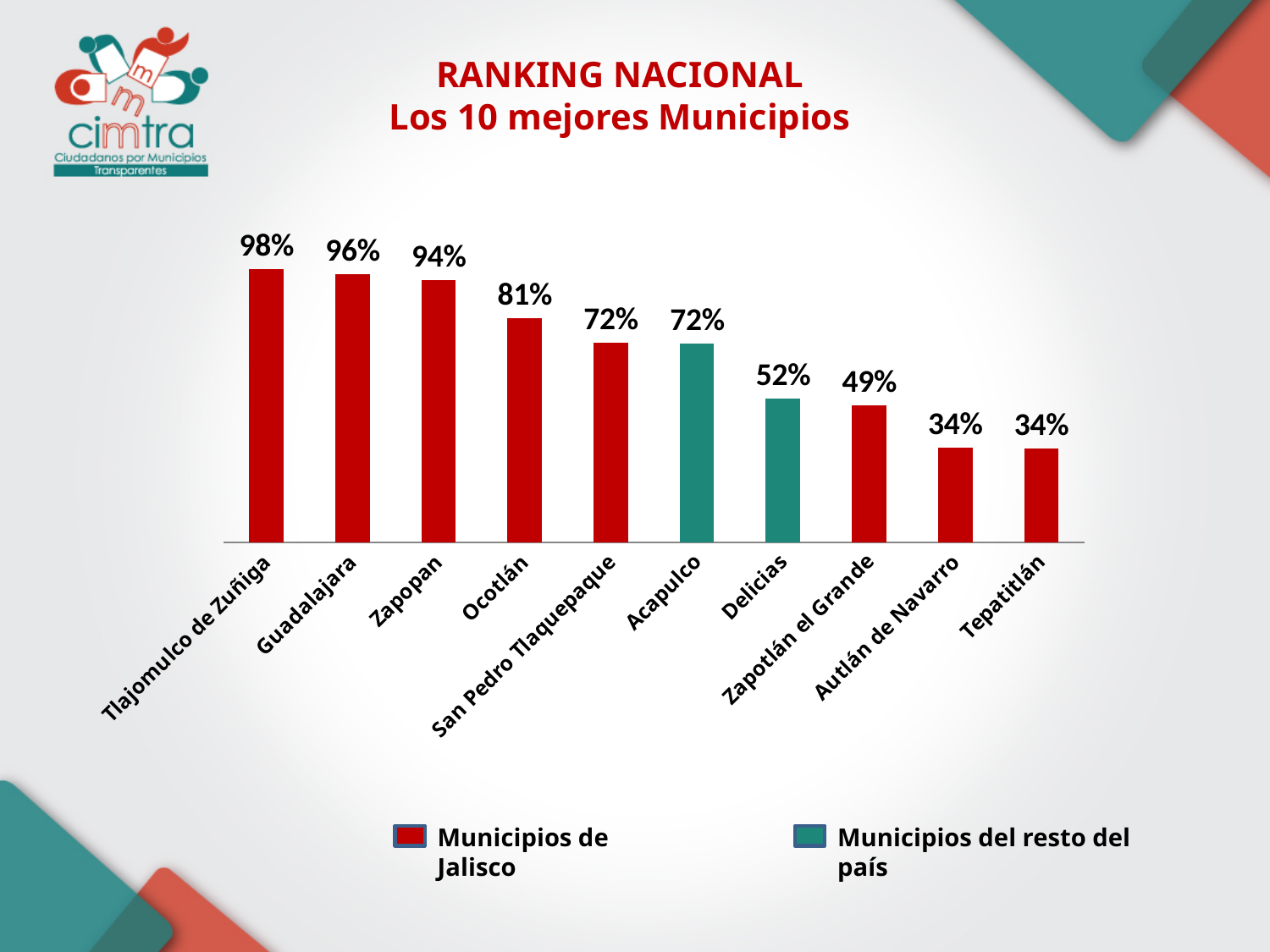
Which legend entry do the teal bars (Acapulco and Delicias) belong to? Municipios del resto del país How many municipalities are shown in the chart? 10 What is the difference between the values for Tlajomulco de Zuñiga and Zapopan? 4% Which municipality has the highest value? Tlajomulco de Zuñiga What kind of chart is shown on the slide? Bar chart Which is larger, the value for Ocotlán or the value for Delicias? Ocotlán What is the value for Delicias? 52% Do the values rise or fall from left to right along the x axis? Fall What is the value for Ocotlán? 81% What is the difference between the values for Acapulco and Zapotlán el Grande? 23% How many series does the legend list? 2 What is the value for Guadalajara? 96%